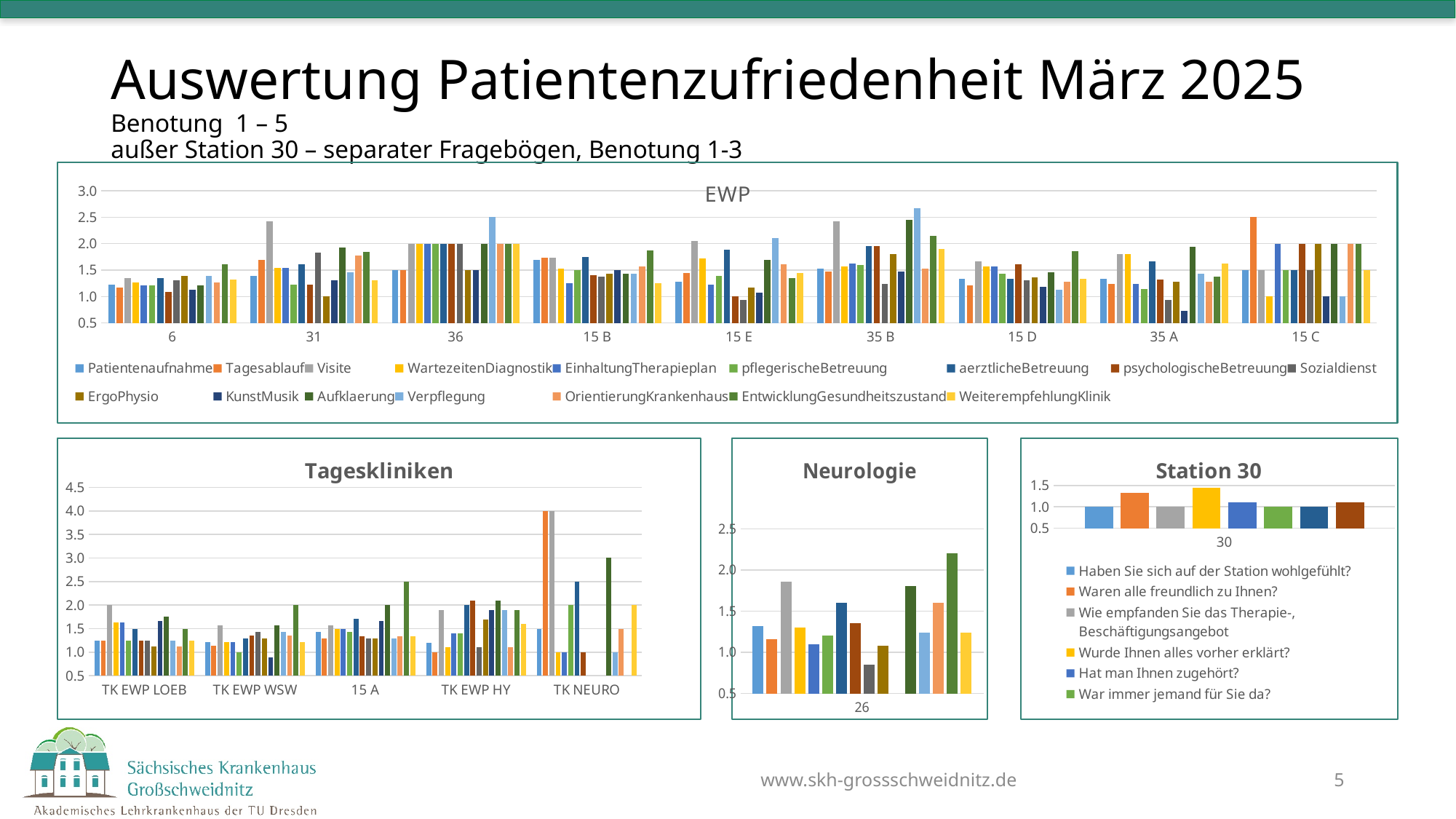
In the Tageskliniken chart, which category contains the tallest bar? TK NEURO How many categories are shown on the x axis of the Tageskliniken chart? 5 In the Station 30 chart, which legend entry has the highest bar? Wurde Ihnen alles vorher erklärt? In the Neurologie chart, what is the only category label on the x axis? 26 What kind of chart is the EWP chart at the top of the slide? bar chart In the Station 30 chart, is the value for "Waren alle freundlich zu Ihnen?" greater or less than 1.0? greater How many categories are shown on the x axis of the EWP chart? 9 What is the title of the chart in the bottom middle of the slide? Neurologie How many series does the legend of the EWP chart list? 16 In the Neurologie chart, is the tallest bar greater or less than 2.0? greater In the Tageskliniken chart, is the tallest bar for TK NEURO greater or less than 3.5? greater How many series does the legend of the Station 30 chart list? 6